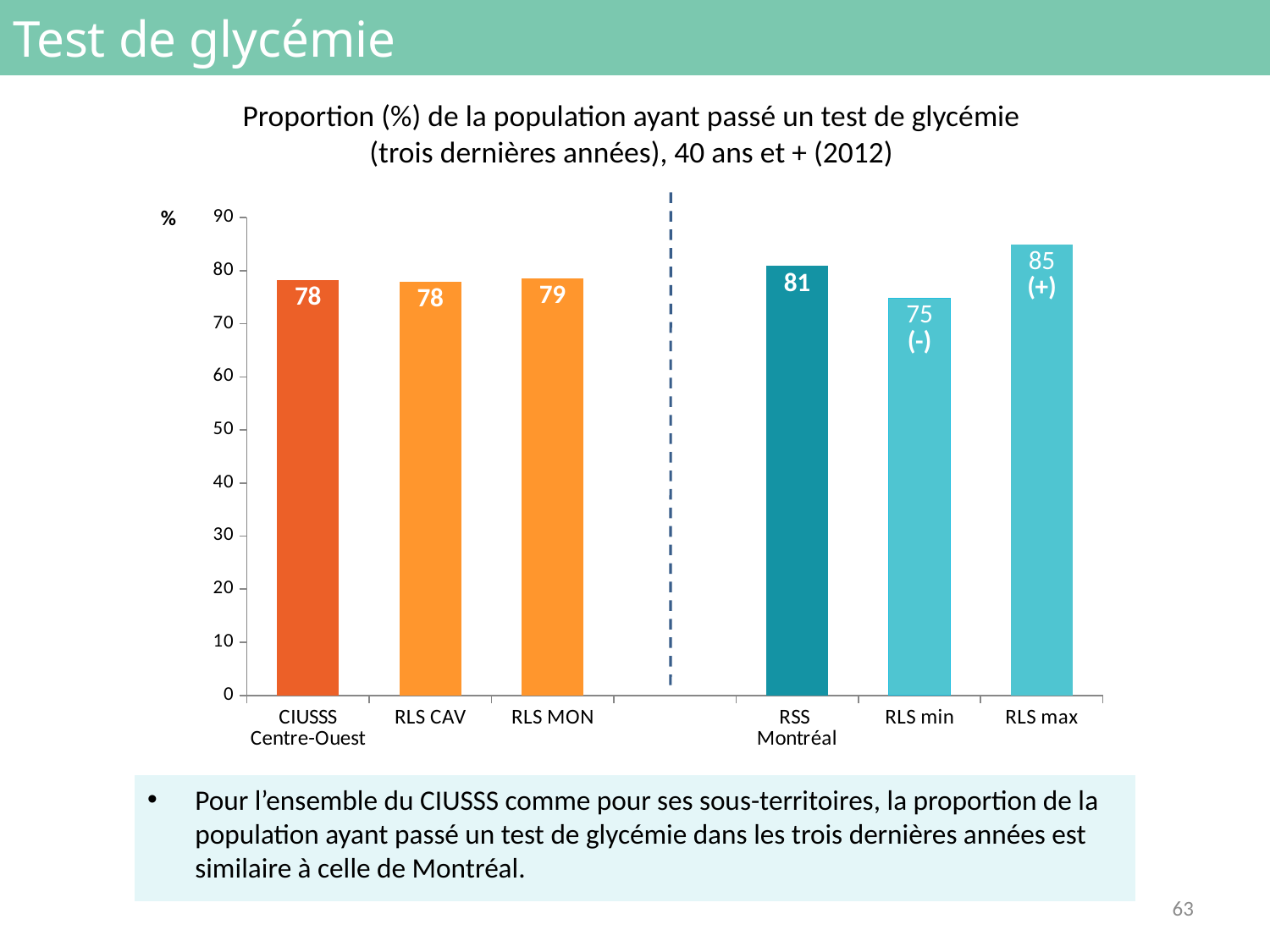
What kind of chart is shown on the slide? bar chart What is the value for RSS Montréal? 81 Which category has the lowest value? RLS min What is the title of the chart? Proportion (%) de la population ayant passé un test de glycémie (trois dernières années), 40 ans et + (2012) How many bars are shown in the chart? 6 Which category has the highest value? RLS max What is the difference between the values for RSS Montréal and CIUSSS Centre-Ouest? 3 Which is larger, the value for RSS Montréal or the value for RLS CAV? RSS Montréal What is the value for RLS min? 75 What is the difference between the values for RLS max and RLS min? 10 What is the value for RLS MON? 79 What is the value for CIUSSS Centre-Ouest? 78